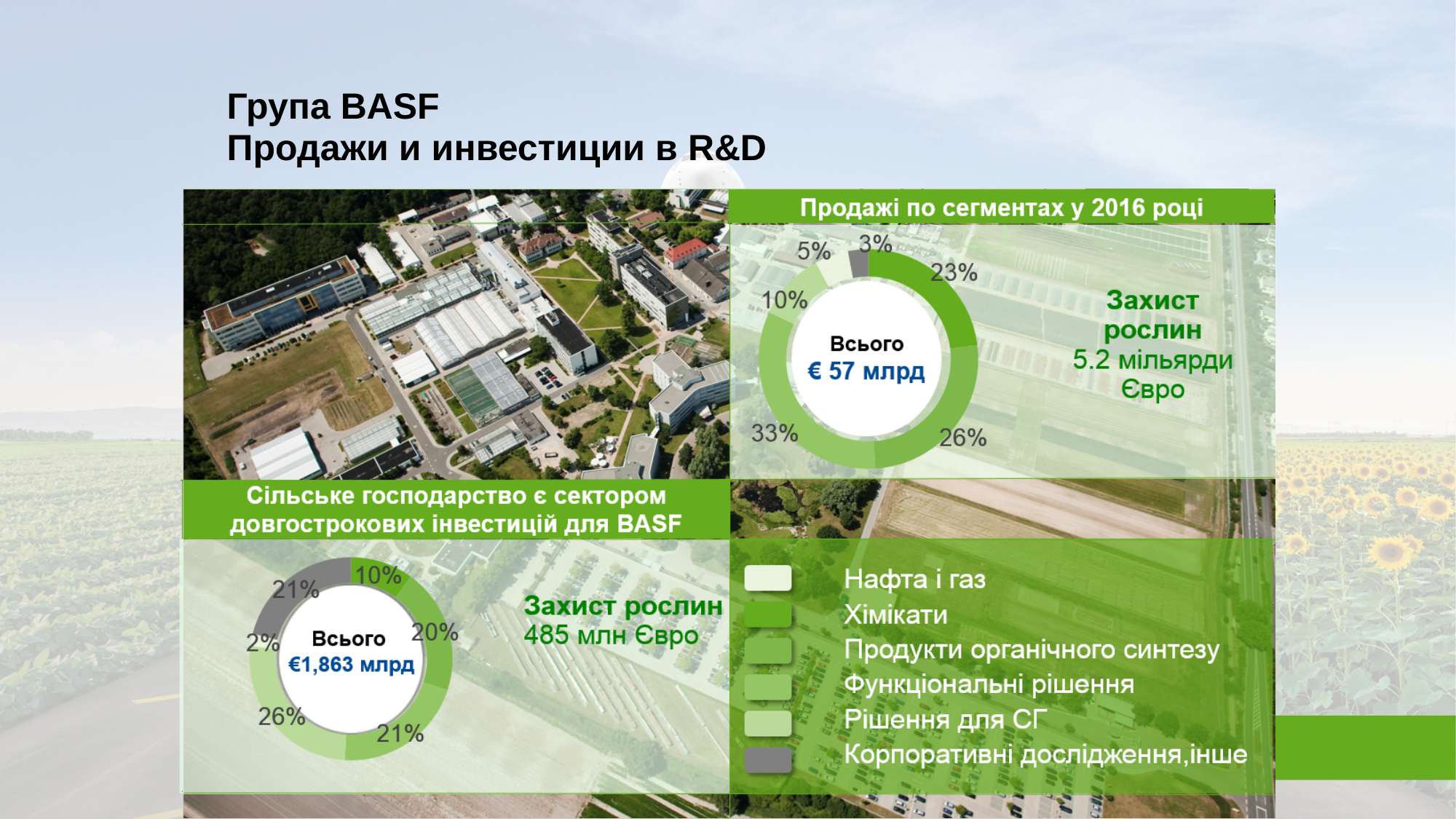
In the 'Продажі по сегментах у 2016 році' chart, what is the smallest percentage slice? 3% In the bottom-left R&D investment chart, what is the smallest percentage slice? 2% In the bottom-left R&D investment chart, what total is shown in the centre? €1,863 млрд In the 'Продажі по сегментах у 2016 році' chart, what is the largest percentage slice? 33% What kind of chart is used in the 'Продажі по сегментах у 2016 році' panel? Donut (pie) chart In the 'Продажі по сегментах у 2016 році' chart, what total is shown in the centre? € 57 млрд In the bottom-left R&D investment chart, what is the largest percentage slice? 26% In the 'Продажі по сегментах у 2016 році' chart, what is the difference between the 33% slice and the 23% slice? 10 percentage points What R&D investment value is given for 'Захист рослин' next to the bottom-left chart? 485 млн Євро What sales value is given for 'Захист рослин' next to the 'Продажі по сегментах у 2016 році' chart? 5.2 мільярди Євро How many slices are labelled in the 'Продажі по сегментах у 2016 році' chart? 6 How many entries does the legend on the bottom right list? 6